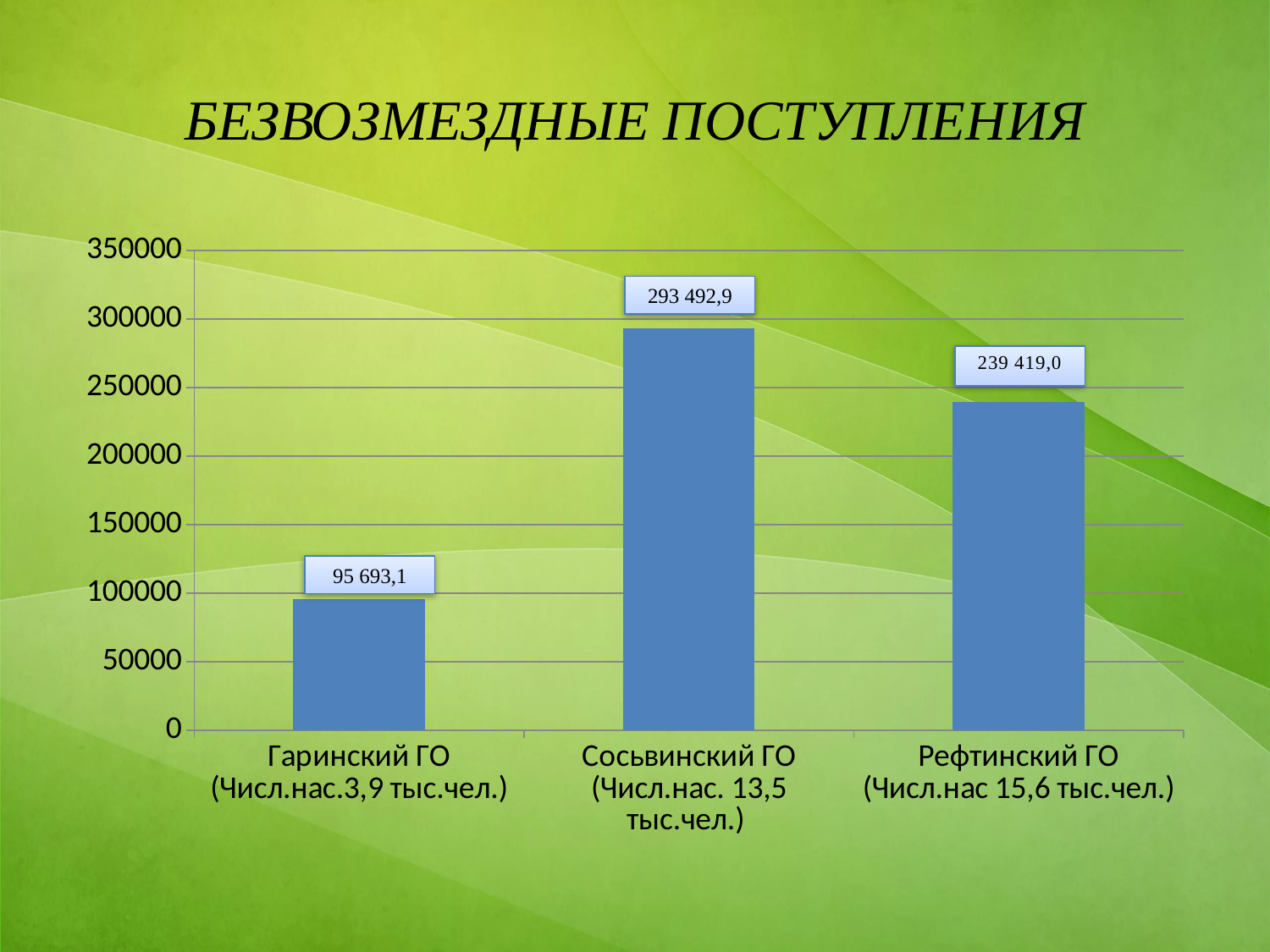
What is the difference between the values for Рефтинский ГО and Гаринский ГО? 143 725,9 What is the value for Сосьвинский ГО? 293 492,9 How many categories are shown in the chart? 3 What is the difference between the values for Сосьвинский ГО and Рефтинский ГО? 54 073,9 Which category has the highest value? Сосьвинский ГО Which category has the lowest value? Гаринский ГО Is the value for Сосьвинский ГО greater or less than 250000? greater What is the value for Рефтинский ГО? 239 419,0 What is the value for Гаринский ГО? 95 693,1 Which is larger, the value for Рефтинский ГО or the value for Гаринский ГО? Рефтинский ГО What kind of chart is shown on the slide? bar chart What is the title of the slide? БЕЗВОЗМЕЗДНЫЕ ПОСТУПЛЕНИЯ